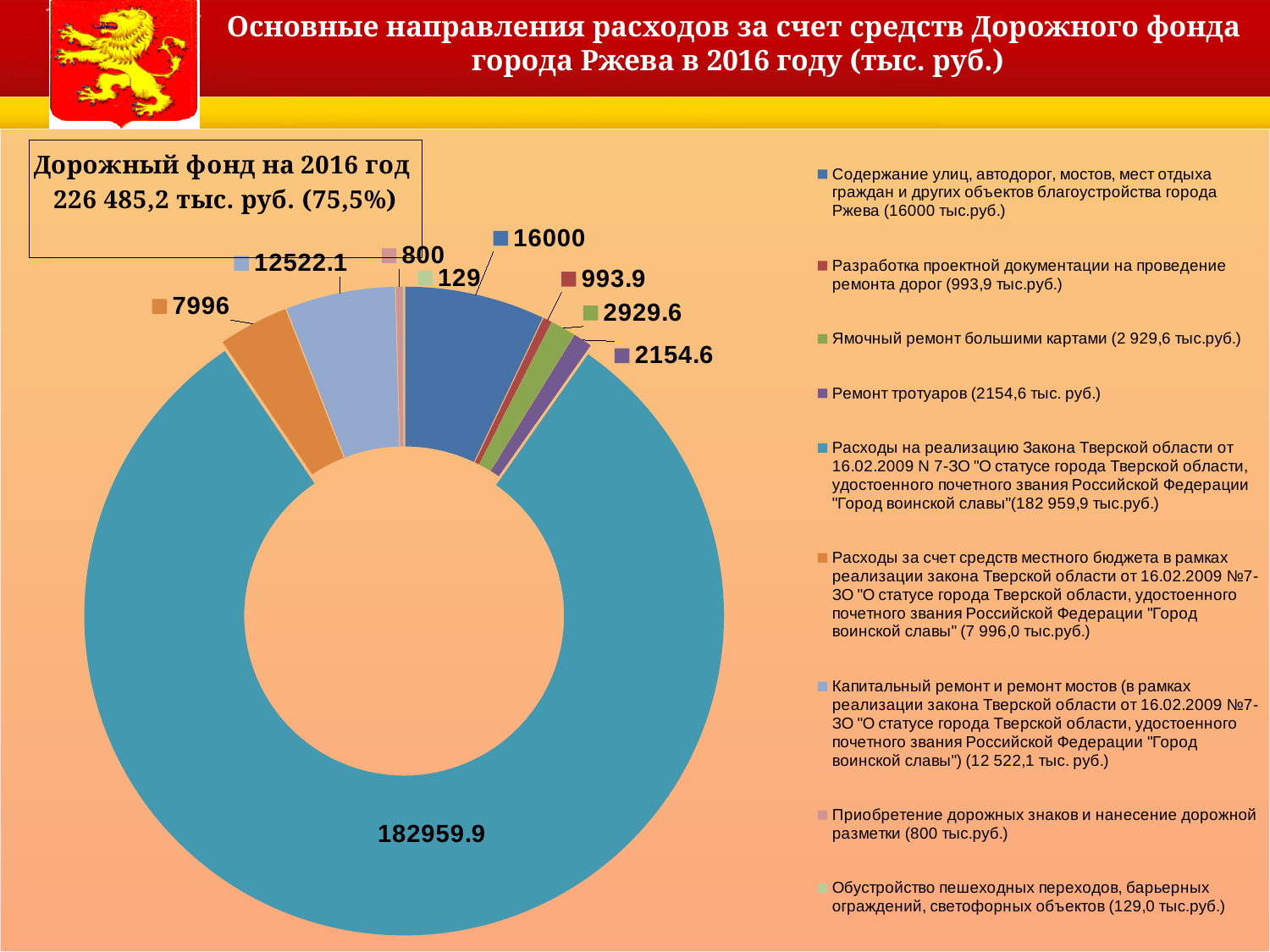
What is the value of the slice for "Ремонт тротуаров"? 2154.6 Which category has the largest slice in the chart? Расходы на реализацию Закона Тверской области от 16.02.2009 N 7-ЗО "О статусе города Тверской области, удостоенного почетного звания Российской Федерации "Город воинской славы" (182959.9) What is the value of the slice for "Содержание улиц, автодорог, мостов, мест отдыха граждан и других объектов благоустройства города Ржева"? 16000 Which category has the smallest slice in the chart? Обустройство пешеходных переходов, барьерных ограждений, светофорных объектов (129) What is the difference between the slice for "Ямочный ремонт большими картами" and the slice for "Ремонт тротуаров"? 775 What is the difference between the slice for "Содержание улиц..." (16000) and the slice for "Капитальный ремонт и ремонт мостов..." (12522.1)? 3477.9 What type of chart is shown on the slide? Doughnut (pie) chart How many slices (categories) does the chart have? 9 What is the value of the slice for "Ямочный ремонт большими картами"? 2929.6 According to the text box on the slide, what is the total size of the road fund for 2016? 226 485,2 тыс. руб. (75,5%) Which is larger: the slice for "Расходы за счет средств местного бюджета..." (7996) or the slice for "Капитальный ремонт и ремонт мостов..." (12522.1)? Капитальный ремонт и ремонт мостов (12522.1) What is the value of the slice for "Приобретение дорожных знаков и нанесение дорожной разметки"? 800